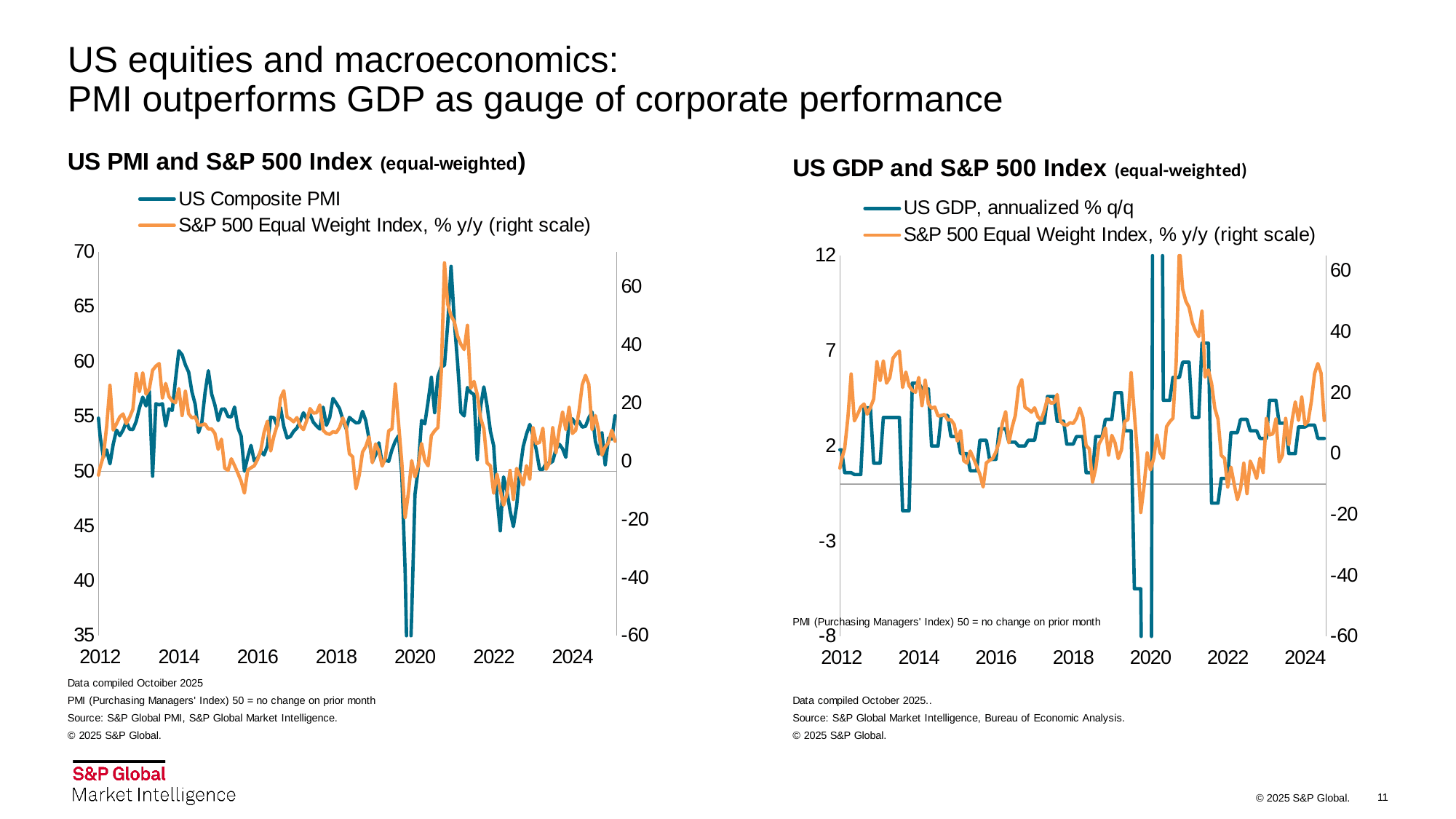
What kind of chart is the right chart, 'US GDP and S&P 500 Index (equal-weighted)'? line chart How many series does the legend of the left chart, 'US PMI and S&P 500 Index', list? 2 In the left chart, 'US PMI and S&P 500 Index', is the peak value of the US Composite PMI line in 2021 greater or less than 65? greater In the right chart, 'US GDP and S&P 500 Index', is the lowest value of the US GDP line in 2020 greater or less than -3? less In the left chart, 'US PMI and S&P 500 Index', which series is plotted on the right scale? S&P 500 Equal Weight Index, % y/y What is the first year shown on the x axis of the left chart, 'US PMI and S&P 500 Index'? 2012 In the right chart, 'US GDP and S&P 500 Index', is the peak value of the S&P 500 Equal Weight Index line in 2021 greater or less than 40 on the right scale? greater In the right chart, 'US GDP and S&P 500 Index', what is the name of the series drawn in dark blue? US GDP, annualized % q/q What kind of chart is the left chart, 'US PMI and S&P 500 Index (equal-weighted)'? line chart How many series does the legend of the right chart, 'US GDP and S&P 500 Index', list? 2